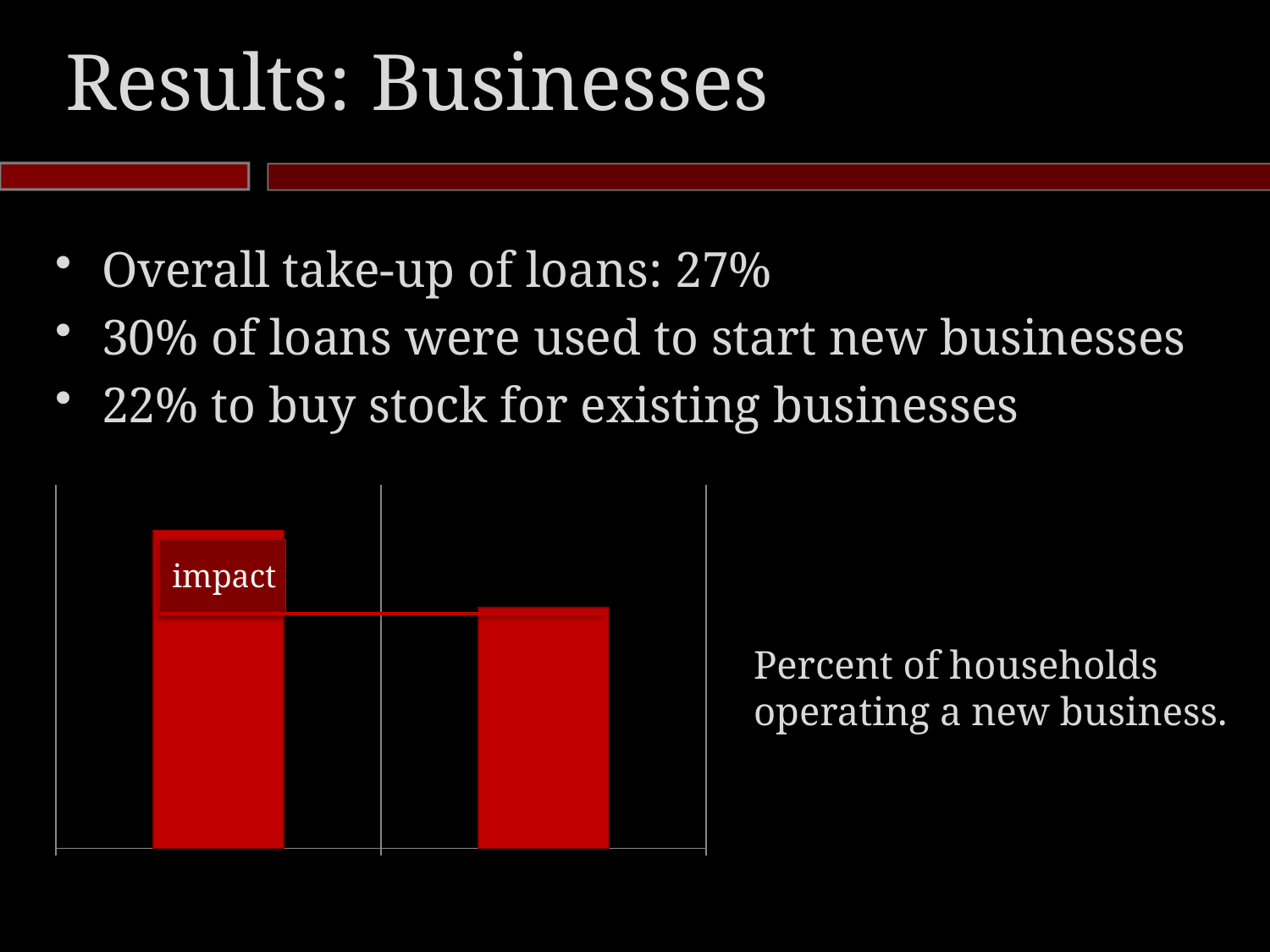
Which bar in the chart is taller, the left bar or the right bar? the left bar What kind of chart is shown on the slide? bar chart How many bars does the chart on the slide contain? 2 Which bar in the chart is the shortest? the right bar What colour are the bars in the chart? red What word is written in the label box overlaid on the chart? impact Do the bar heights rise or fall from left to right across the chart? fall